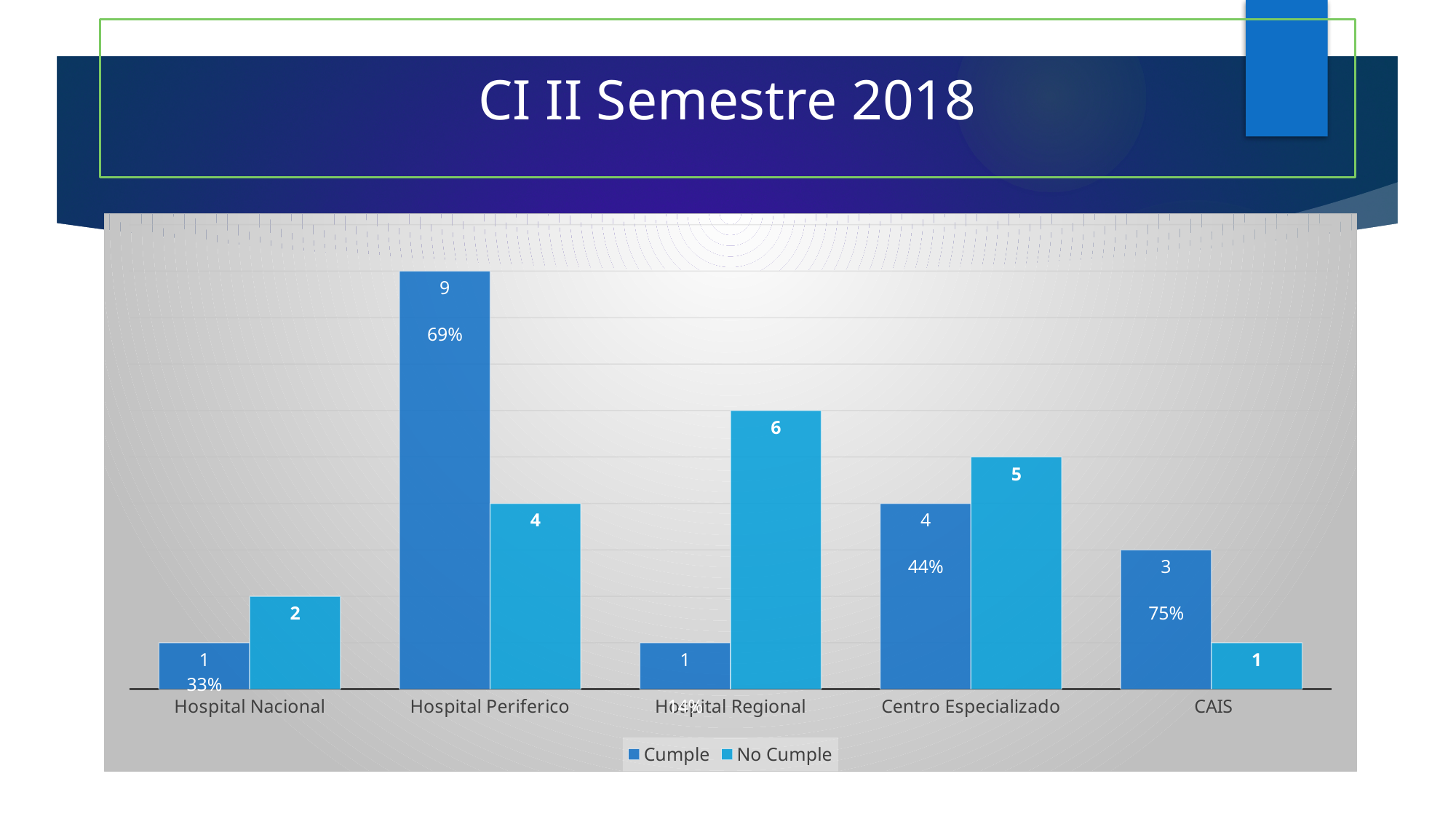
Which is larger for Centro Especializado, Cumple or No Cumple? No Cumple What percentage is shown on the Cumple bar for CAIS? 75% What is the No Cumple value for Hospital Regional? 6 Which category has the lowest No Cumple value? CAIS What kind of chart is shown on the slide? Bar chart What is the title of the slide containing the chart? CI II Semestre 2018 What is the difference between the Cumple and No Cumple values for Hospital Periferico? 5 What is the Cumple value for Hospital Periferico? 9 Which category has the highest Cumple value? Hospital Periferico What is the No Cumple value for Centro Especializado? 5 How many categories are shown on the x axis? 5 How many series does the legend list? 2